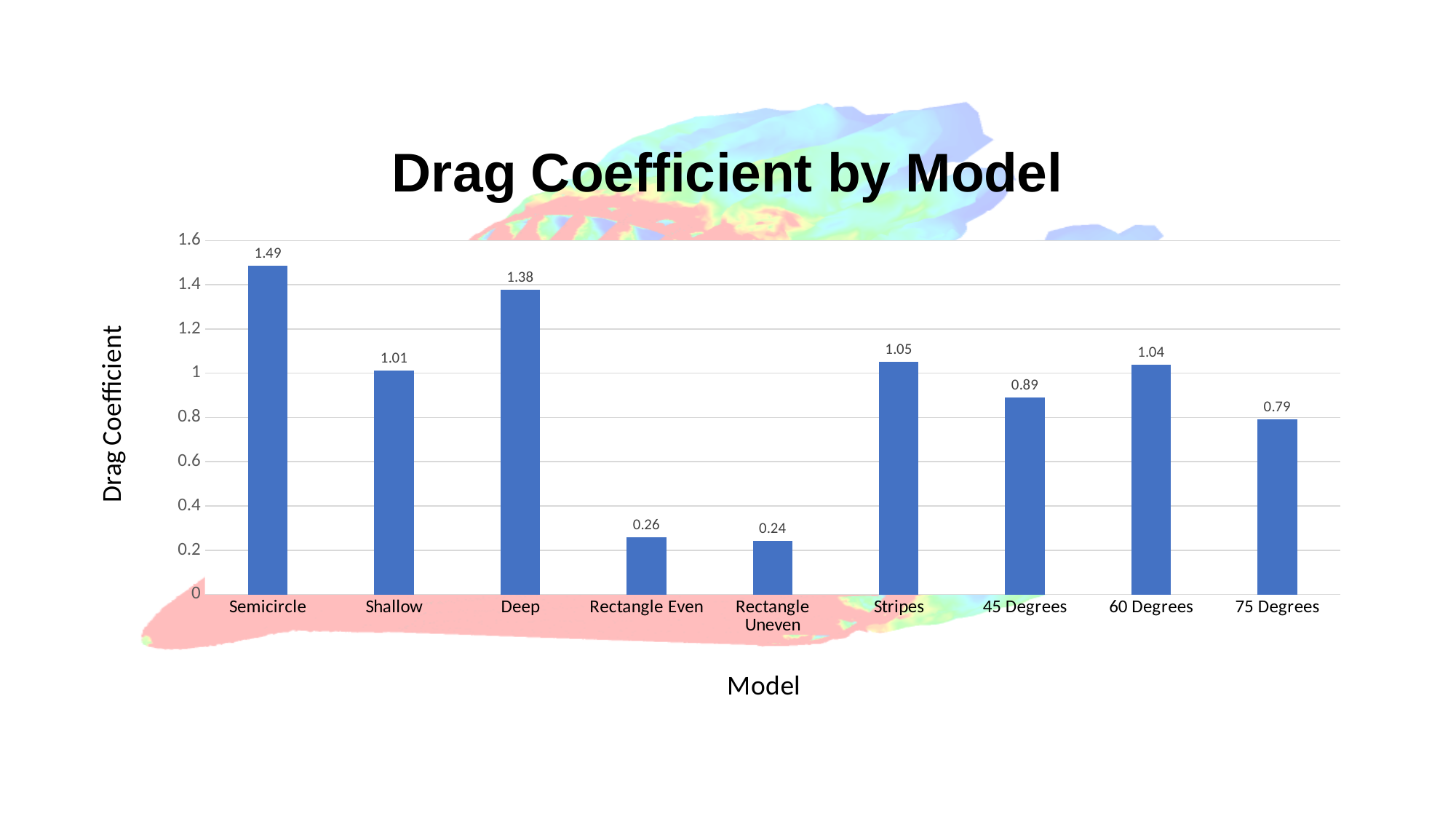
What is the drag coefficient for the Rectangle Uneven model? 0.24 What is the title of the chart? Drag Coefficient by Model Is the drag coefficient for the Deep model greater or less than 1.2? greater How many models are shown on the x axis? 9 What kind of chart is shown on the slide? Bar chart What is the difference between the drag coefficients of the Stripes and 75 Degrees models? 0.26 Which model has the lowest drag coefficient? Rectangle Uneven Which model has the highest drag coefficient? Semicircle What is the drag coefficient for the 60 Degrees model? 1.04 Which has a larger drag coefficient, Shallow or 45 Degrees? Shallow What is the drag coefficient for the Semicircle model? 1.49 What is the difference between the drag coefficients of the Semicircle and Deep models? 0.11